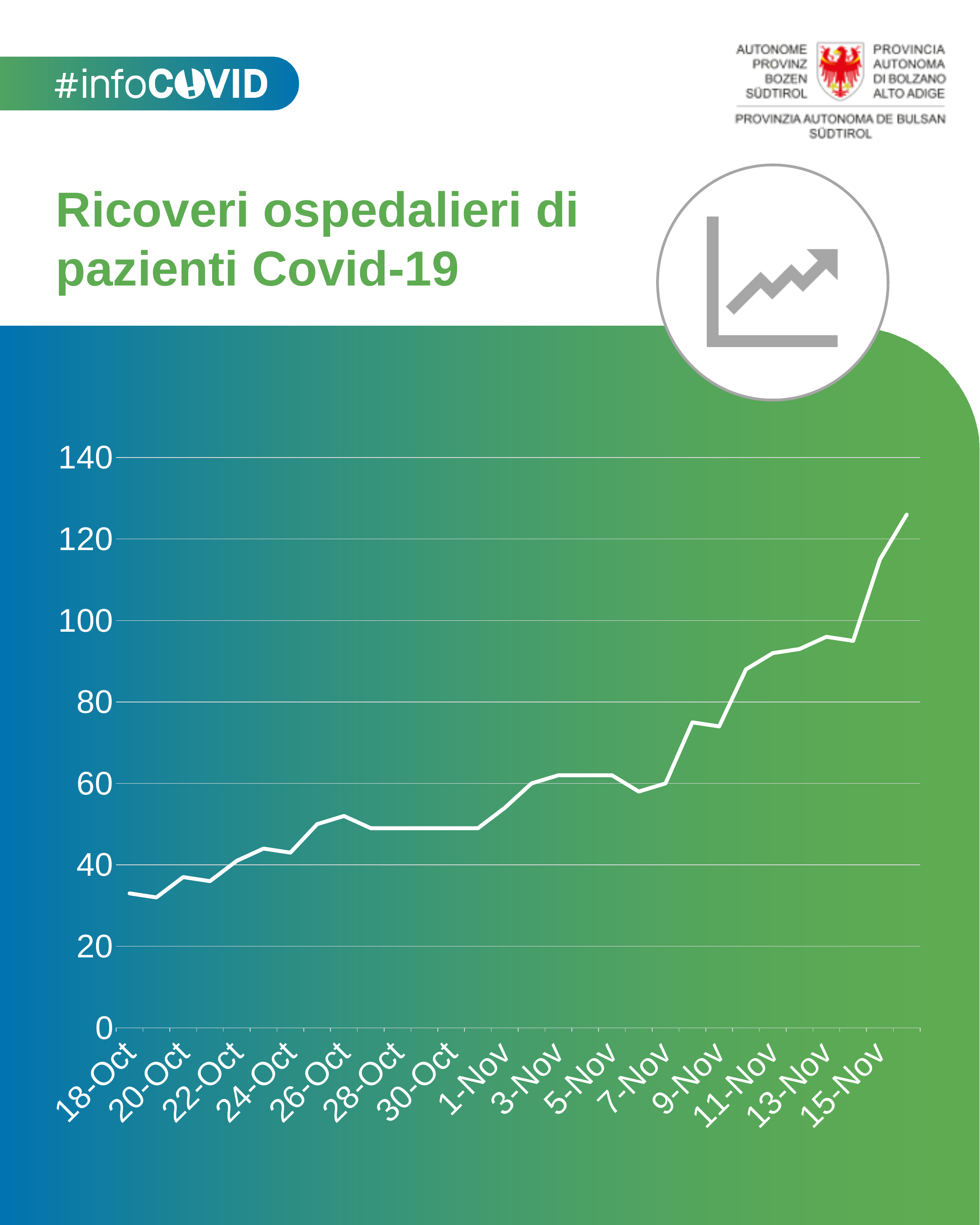
What is the highest value shown on the y axis? 140 Is the value for 15-Nov greater or less than 100? greater Is the value for 28-Oct greater or less than 60? less Is the value for 18-Oct greater or less than 40? less Do the values generally rise or fall from 18-Oct to 15-Nov? rise How many date labels are shown on the x axis? 15 Is the value for 15-Nov larger or smaller than the value for 18-Oct? larger What kind of chart is shown on the slide? line chart What is the title of the chart? Ricoveri ospedalieri di pazienti Covid-19